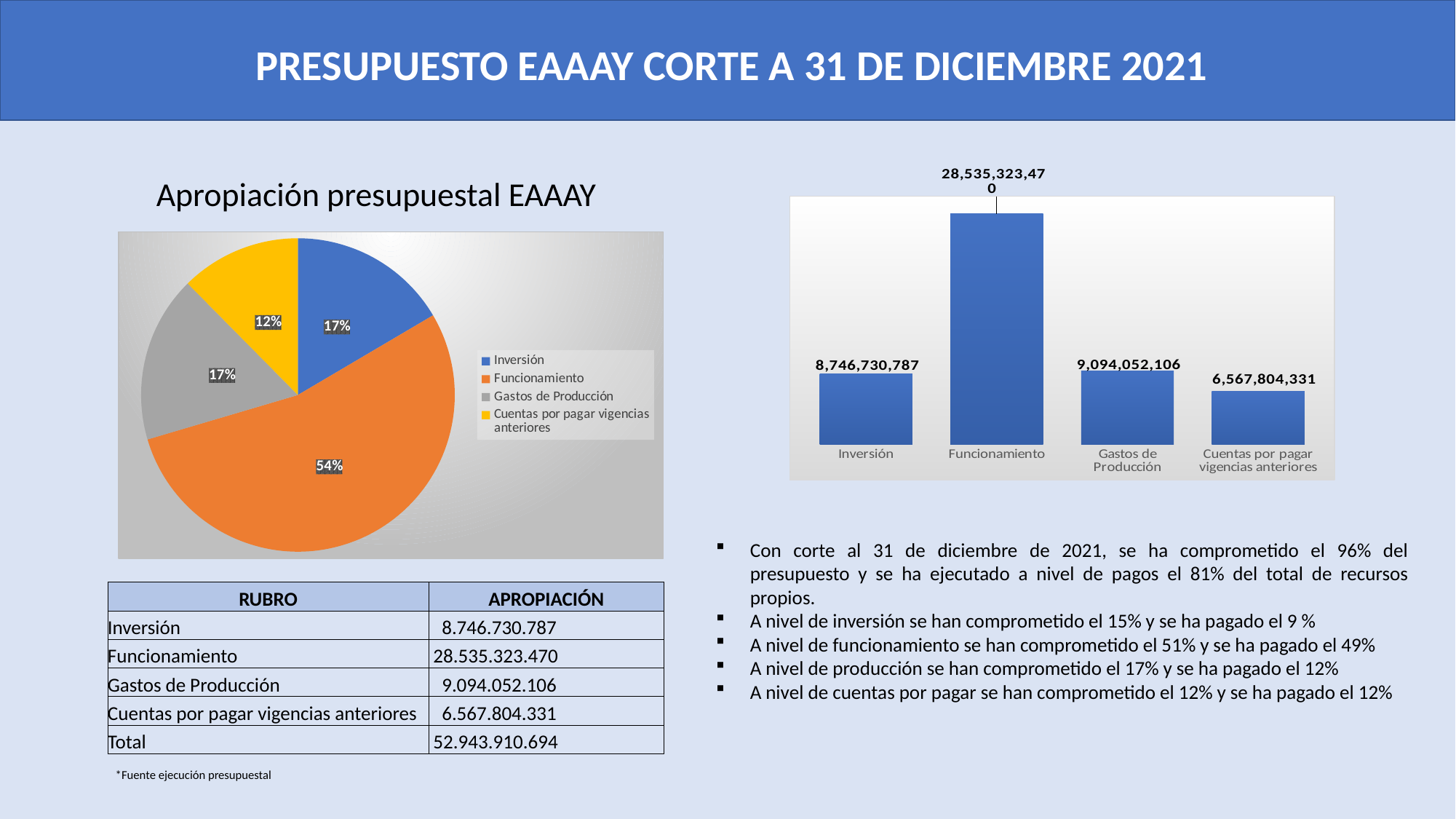
In the pie chart 'Apropiación presupuestal EAAAY', which category has the smallest slice? Cuentas por pagar vigencias anteriores In the bar chart on the right, which category has the lowest value? Cuentas por pagar vigencias anteriores In the bar chart on the right, which is larger: Gastos de Producción or Inversión? Gastos de Producción What kind of chart is the chart on the left of the slide? Pie chart In the pie chart 'Apropiación presupuestal EAAAY', what share does Funcionamiento have? 54% What kind of chart is the chart on the right of the slide? Bar chart In the pie chart 'Apropiación presupuestal EAAAY', what share does Cuentas por pagar vigencias anteriores have? 12% In the bar chart on the right, what is the value for Gastos de Producción? 9,094,052,106 In the pie chart 'Apropiación presupuestal EAAAY', which category has the largest slice? Funcionamiento In the bar chart on the right, what is the difference between Funcionamiento and Inversión? 19,788,592,683 How many categories does the legend of the pie chart 'Apropiación presupuestal EAAAY' list? 4 In the bar chart on the right, what is the value for Inversión? 8,746,730,787